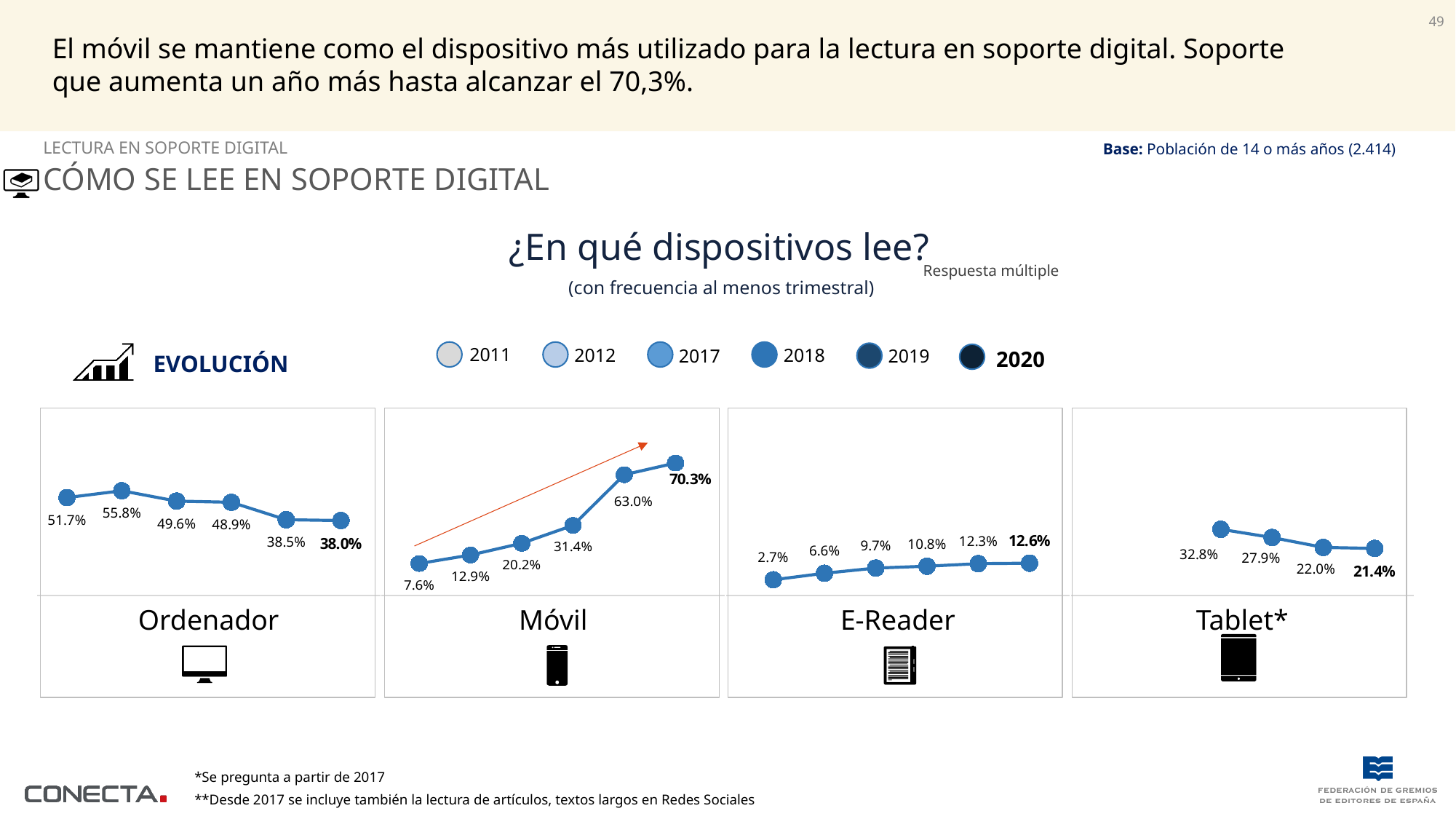
In the Ordenador chart, which year has the highest value? 2012 In the Móvil chart, what is the difference between the 2020 value and the 2019 value? 7.3% In the Tablet* chart, what is the value for 2017? 32.8% In the Ordenador chart, what is the value for 2011? 51.7% Which is larger for 2020: the Ordenador value or the Tablet* value? Ordenador In the Tablet* chart, what is the difference between the 2017 value and the 2020 value? 11.4% Do the values in the E-Reader chart rise or fall from 2011 to 2020? rise How many years does the legend list? 6 In the E-Reader chart, what is the value for 2019? 12.3% How many data points are plotted in the Tablet* chart? 4 In the Móvil chart, what is the value for 2020? 70.3% In the Móvil chart, which year has the lowest value? 2011